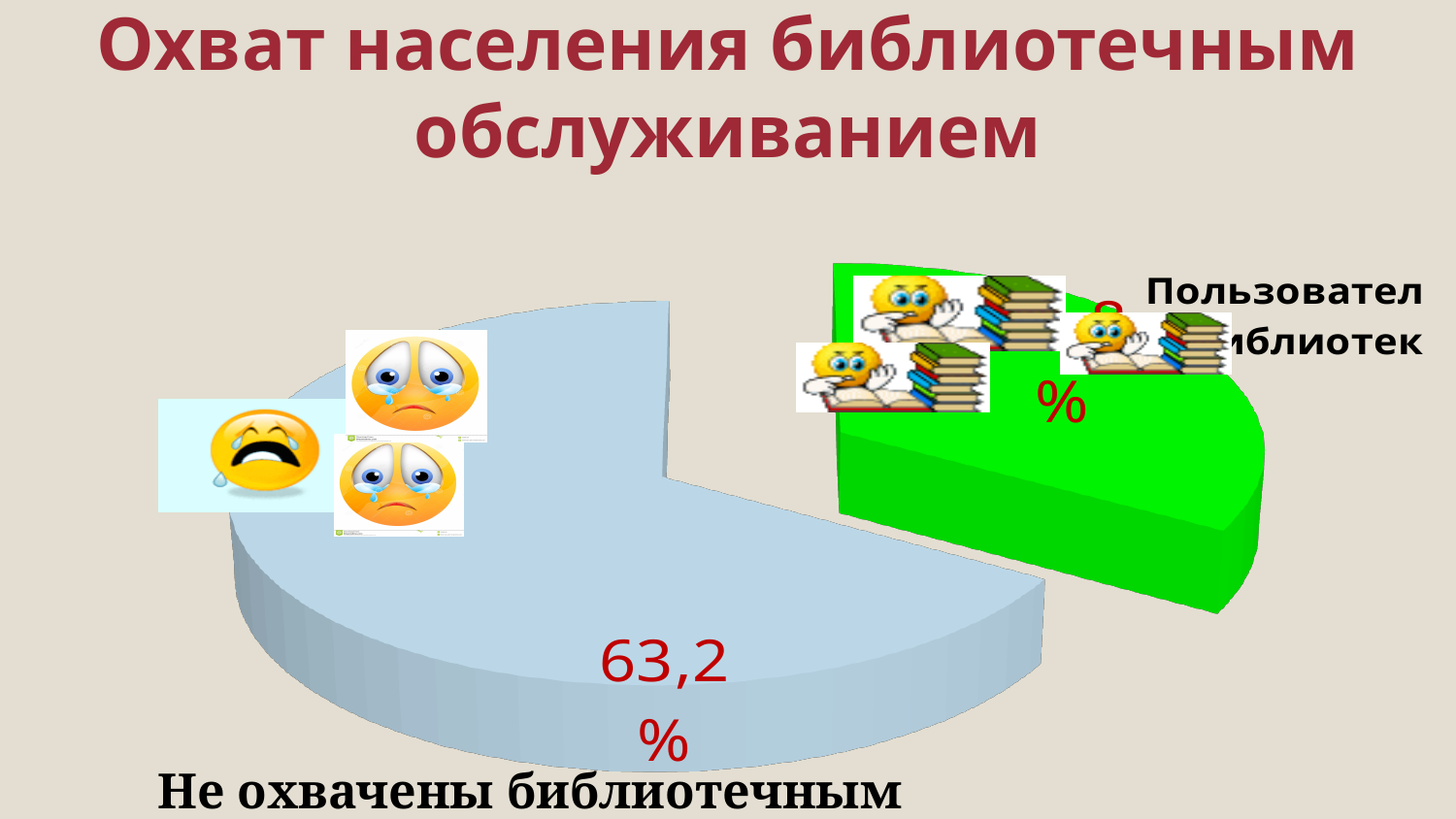
Does the "Не охвачены библиотечным" slice make up more or less than half of the pie? more Which slice is larger: "Не охвачены библиотечным" or "Пользователи библиотек"? Не охвачены библиотечным How many slices does the pie chart have? 2 What is the title of the chart on the slide? Охват населения библиотечным обслуживанием What colour is the slice for "Пользователи библиотек"? green Which slice of the pie chart is the largest? Не охвачены библиотечным What kind of chart is shown on the slide? pie chart What percentage is shown for the slice labelled "Не охвачены библиотечным"? 63,2 % Which slice of the pie chart is the smallest? Пользователи библиотек